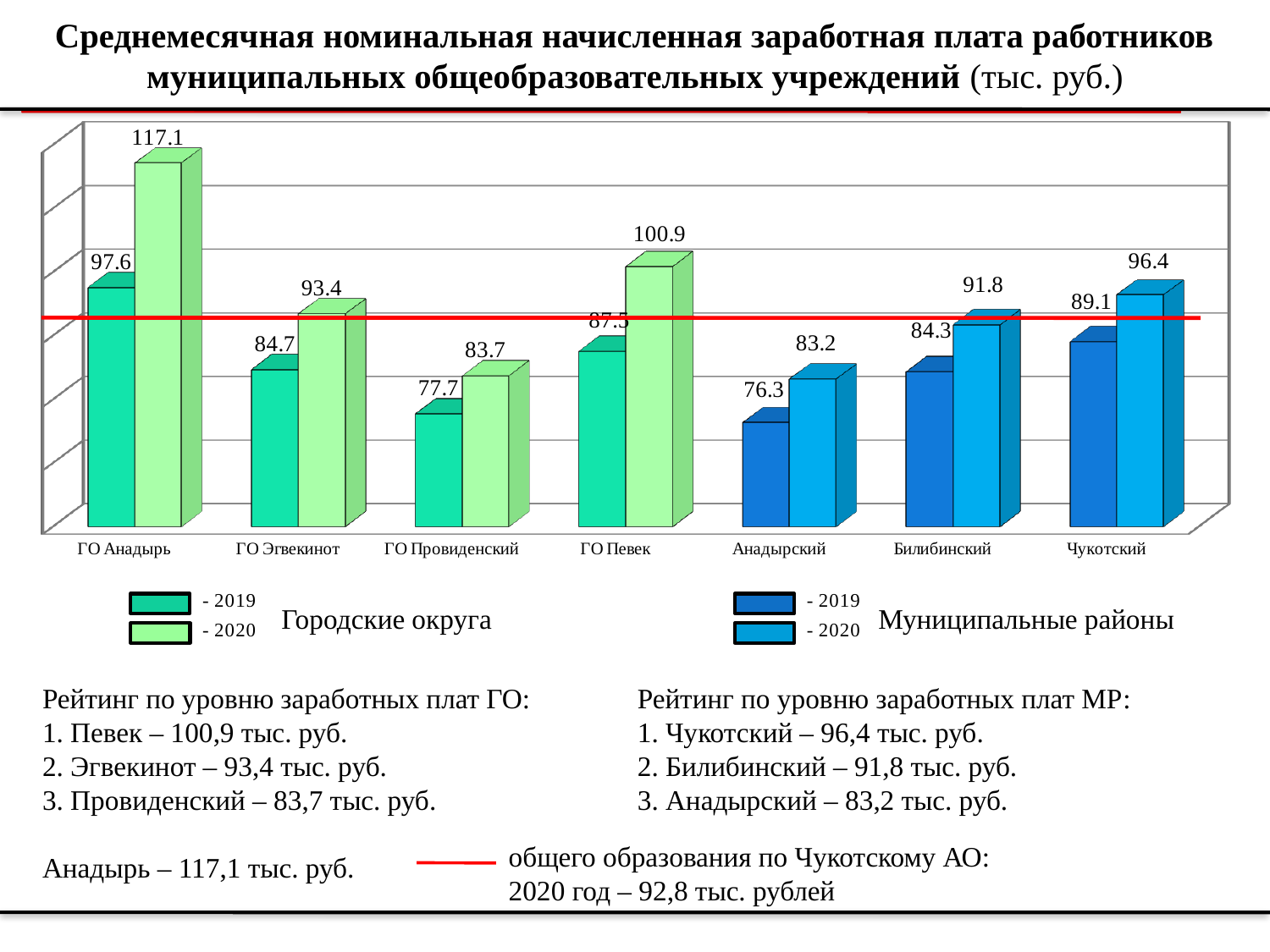
What is the difference between the 2020 and 2019 values for ГО Анадырь? 19.5 What is the 2020 value for ГО Анадырь? 117.1 What is the difference between the 2020 values for ГО Певек and ГО Эгвекинот? 7.5 Which category has the highest 2020 value? ГО Анадырь What is the 2019 value for ГО Провиденский? 77.7 What kind of chart is shown on the slide? bar chart What is the 2019 value for Билибинский? 84.3 Which category has the lowest 2019 value? Анадырский How many categories are shown on the x axis of the chart? 7 What is the 2020 value for Чукотский? 96.4 Which is larger, the 2020 value for Билибинский or the 2020 value for ГО Эгвекинот? ГО Эгвекинот For each category, is the 2020 value higher or lower than the 2019 value? higher